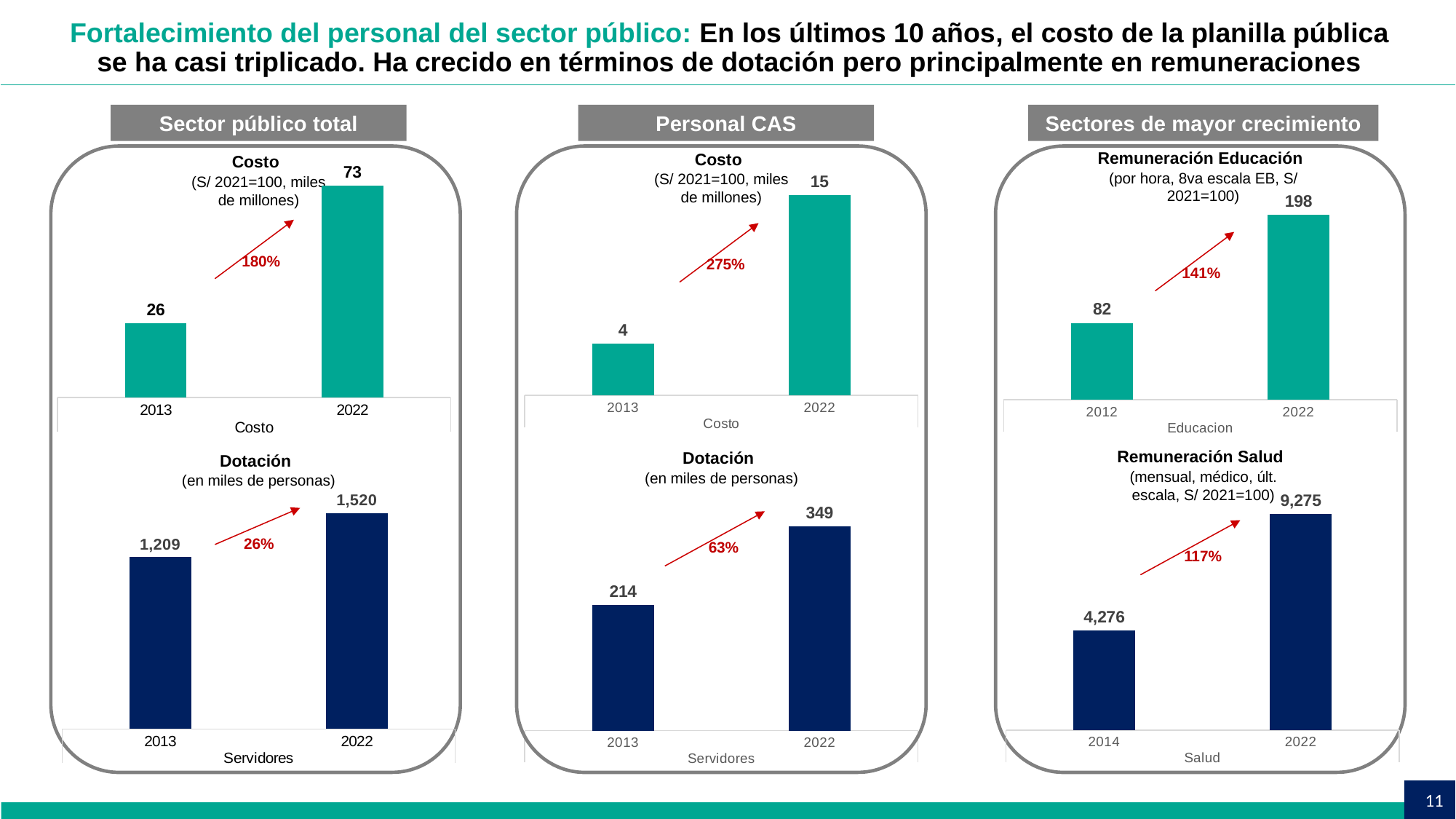
In the 'Dotación' chart under 'Sector público total', what is the difference between the 2022 and 2013 values? 311 In the 'Dotación' chart under 'Sector público total', what is the value for 2022? 1,520 In the 'Costo' chart under 'Sector público total', what is the value for 2013? 26 In the 'Costo' chart under 'Sector público total', what is the value for 2022? 73 What type of chart is the 'Remuneración Educación' chart? Bar chart In the 'Remuneración Salud' chart, which year has the higher value, 2014 or 2022? 2022 In the 'Remuneración Educación' chart, what is the value for 2012? 82 In the 'Costo' chart under 'Personal CAS', what is the value for 2013? 4 In the 'Remuneración Salud' chart, what is the value for 2022? 9,275 In the 'Dotación' chart under 'Personal CAS', what is the value for 2022? 349 In the 'Costo' chart under 'Personal CAS', what is the difference between the 2022 and 2013 values? 11 In the 'Dotación' chart under 'Personal CAS', how many bars are plotted? 2